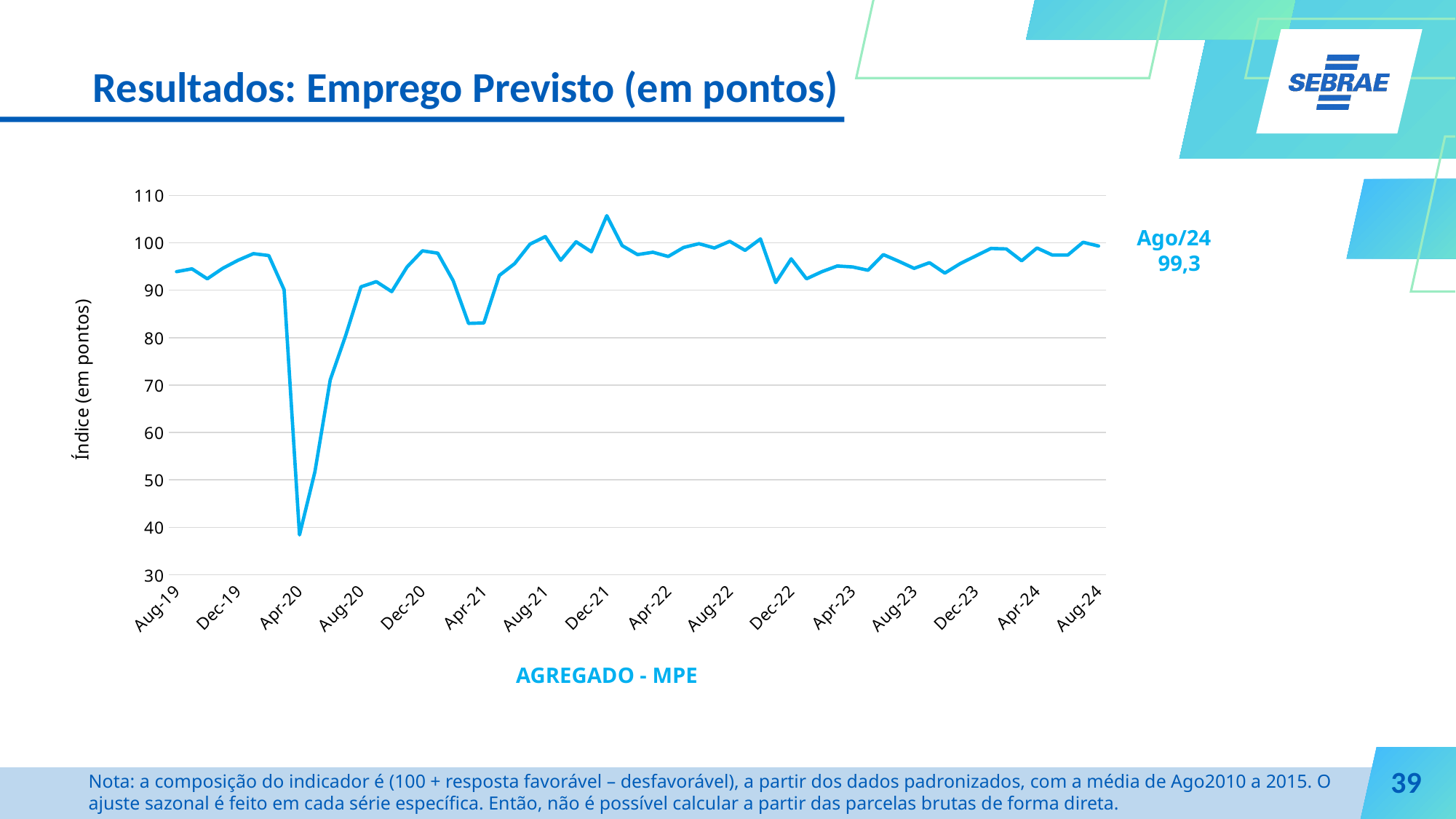
What is the value of the AGREGADO - MPE index for Ago/24 (Aug-24)? 99,3 What is the title of the vertical axis? Índice (em pontos) Is the value for Apr-21 greater or less than 90? less Is the value for Apr-20 greater or less than 50? less At which x-axis label does the AGREGADO - MPE line reach its highest point? Dec-21 Does the line rise or fall between Apr-20 and Aug-20? rise At which x-axis label does the AGREGADO - MPE line reach its lowest point? Apr-20 What kind of chart is shown on the slide? line chart Which is larger, the value for Aug-24 or the value for Apr-20? Aug-24 Is the value for Dec-21 greater or less than 100? greater